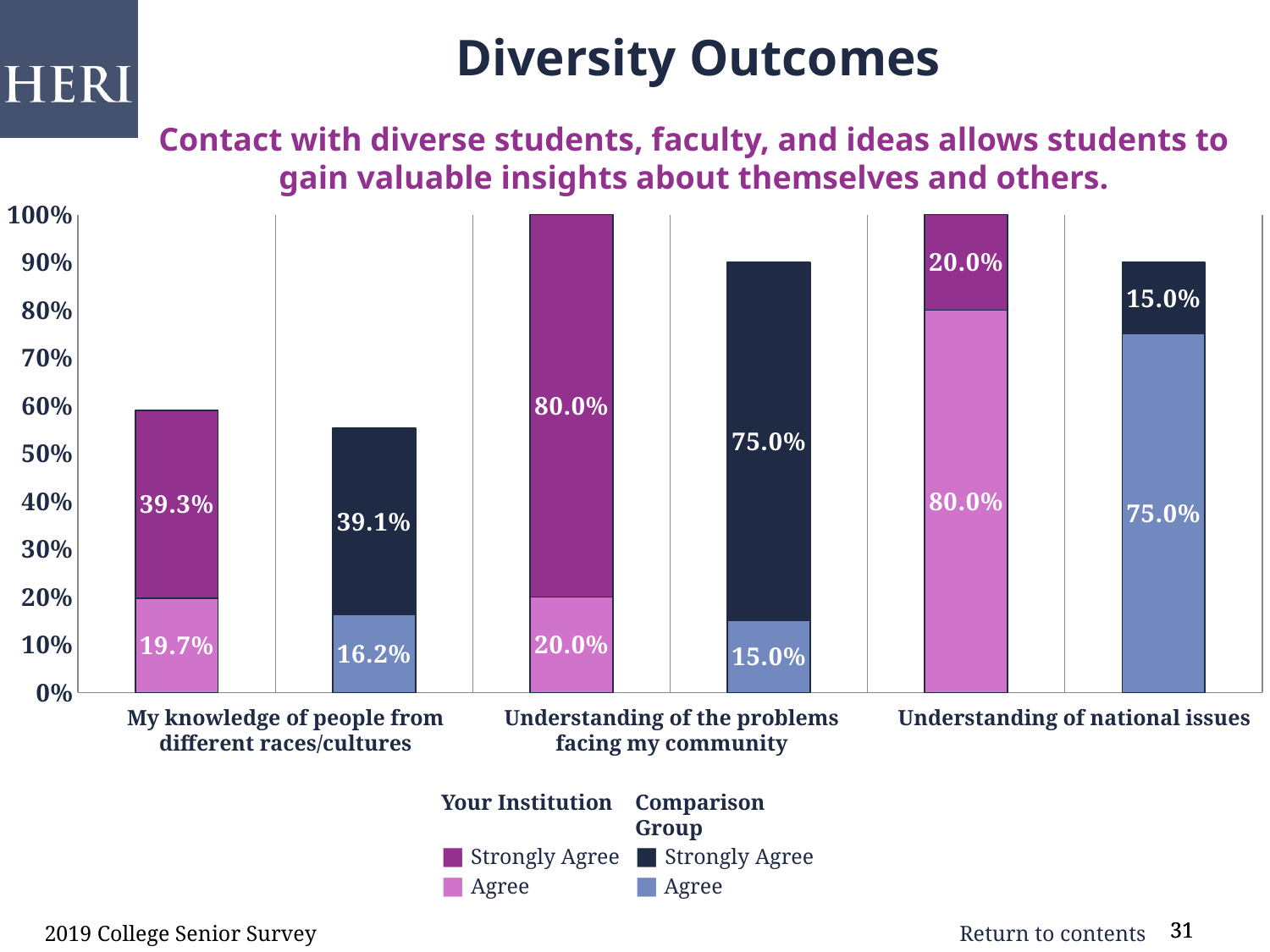
What is the total of the Your Institution stacked bar for 'My knowledge of people from different races/cultures'? 59.0% What is the Your Institution 'Strongly Agree' value for 'Understanding of the problems facing my community'? 80.0% Which is larger for 'My knowledge of people from different races/cultures': the Your Institution 'Agree' value or the Comparison Group 'Agree' value? Your Institution 'Agree' (19.7%) How many series does the legend list? 4 What is the total of the Comparison Group stacked bar for 'Understanding of the problems facing my community'? 90.0% What is the difference between the Your Institution 'Agree' value and the Comparison Group 'Agree' value for 'Understanding of national issues'? 5.0% What kind of chart is shown on the slide? Stacked bar chart How many categories are shown on the x axis? 3 Is the total of the Comparison Group stacked bar for 'My knowledge of people from different races/cultures' greater or less than 60%? less What is the Your Institution 'Strongly Agree' value for 'My knowledge of people from different races/cultures'? 39.3% What is the Comparison Group 'Agree' value for 'Understanding of national issues'? 75.0% What is the Comparison Group 'Agree' value for 'My knowledge of people from different races/cultures'? 16.2%